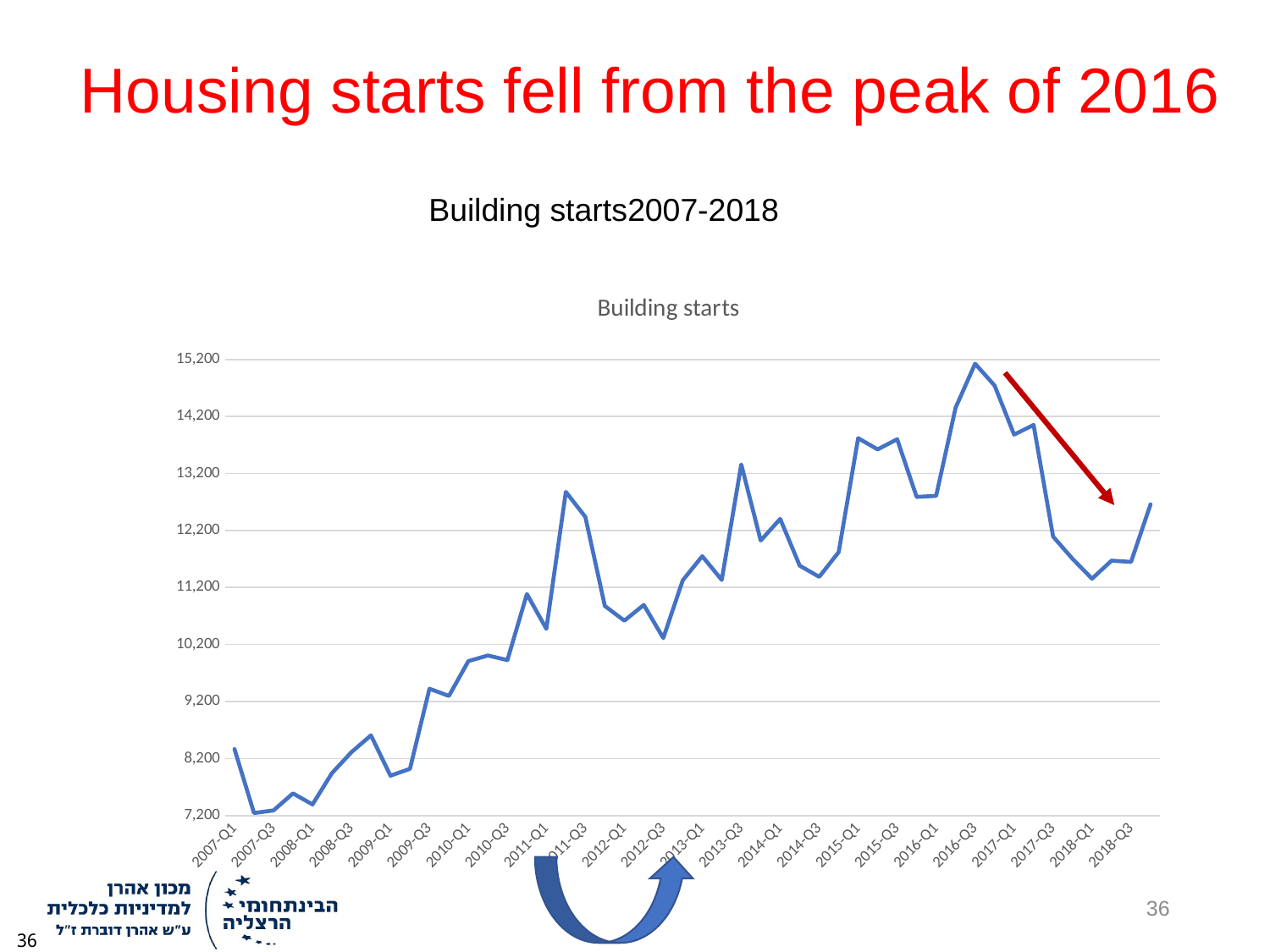
Which is larger, the value for 2007-Q1 or the value for 2011-Q1? 2011-Q1 Is the value for 2007-Q1 greater or less than 9,200? less In which quarter do building starts reach their highest value? 2016-Q3 What kind of chart is shown on the slide? Line chart Is the value for 2018-Q1 greater or less than 12,200? less What is the title of the chart? Building starts Is the value for 2011-Q3 greater or less than 12,200? greater Do building starts rise or fall between 2016-Q3 and 2018-Q1? Fall Which is larger, the value for 2016-Q3 or the value for 2018-Q3? 2016-Q3